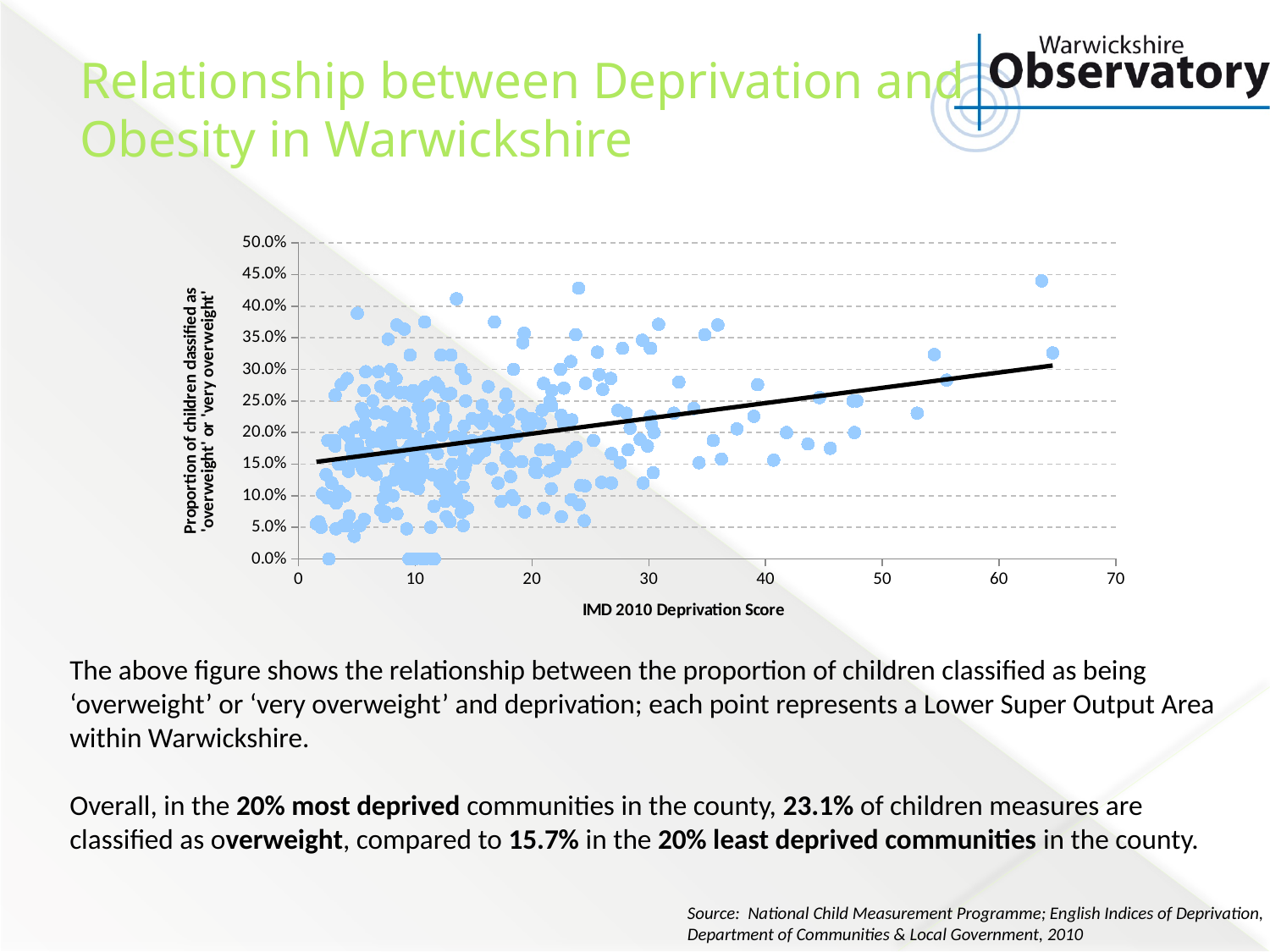
Is the highest plotted point on the chart greater or less than 40%? greater Does the trend line rise or fall as the IMD 2010 Deprivation Score increases? rise What is the interval between consecutive tick marks on the y axis? 5.0% What is the title of the y axis of the chart? Proportion of children classified as 'overweight' or 'very overweight' What is the highest value shown on the y axis of the chart? 50.0% Is the trend line value at a deprivation score of 60 greater or less than 25%? greater What kind of chart is shown on the slide? scatter chart What is the title of the x axis of the chart? IMD 2010 Deprivation Score Is the trend line value at a deprivation score of 10 greater or less than 25%? less What is the interval between consecutive tick marks on the x axis? 10 What is the highest value shown on the x axis of the chart? 70